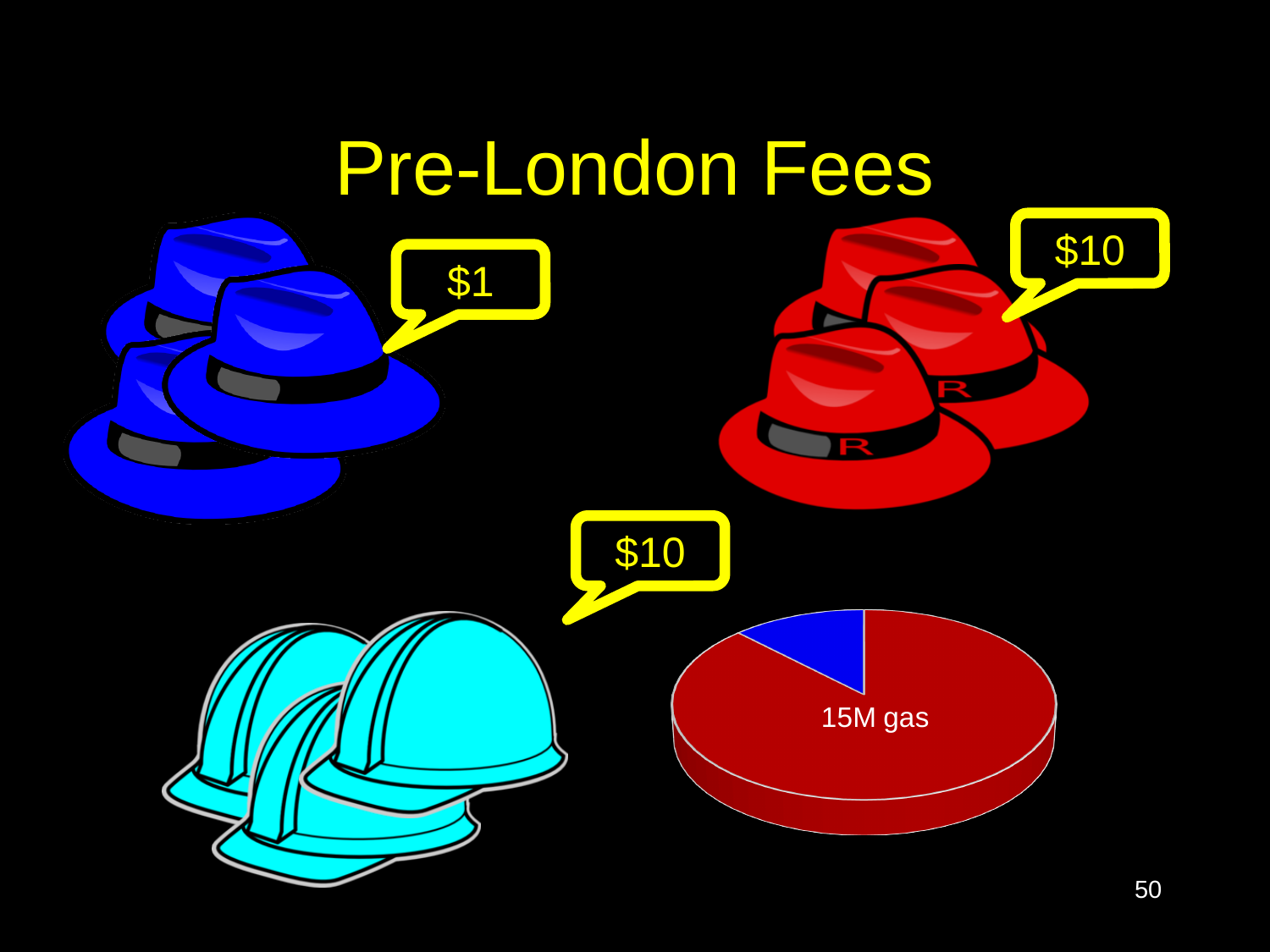
How many slices does the pie chart have? 2 What text label is printed on the pie chart? 15M gas Does the red slice of the pie chart take up more or less than half of the pie? more Which slice of the pie chart is the smallest? the blue slice What kind of chart is shown at the bottom right of the slide? pie chart What colour is the smaller slice of the pie chart? blue Which slice of the pie chart is larger, the red one or the blue one? red